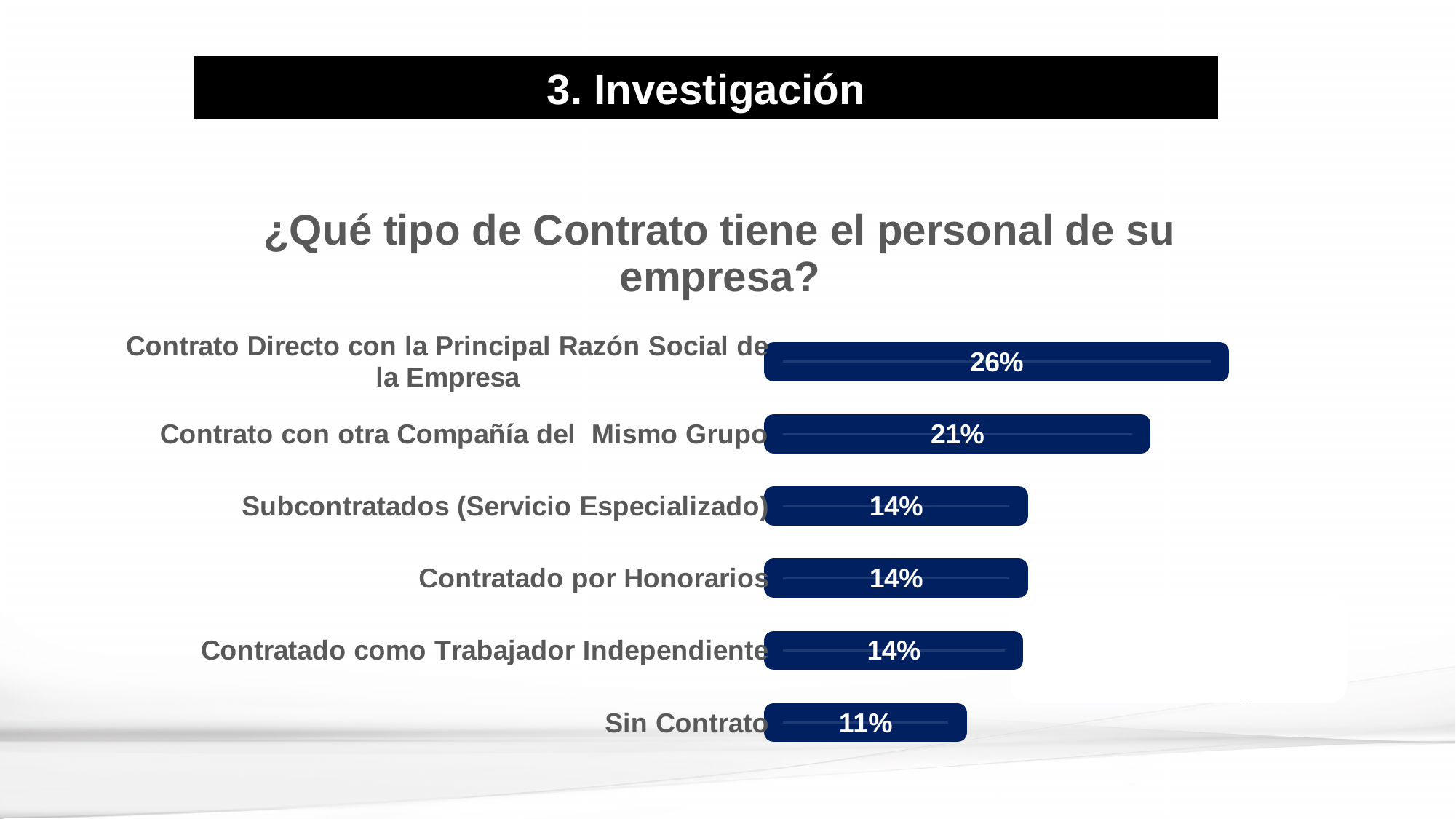
How many categories are shown in the chart? 6 Which category has the highest value? Contrato Directo con la Principal Razón Social de la Empresa What is the value for "Contrato Directo con la Principal Razón Social de la Empresa"? 26% Which is larger, the value for "Contrato con otra Compañía del Mismo Grupo" or the value for "Contratado como Trabajador Independiente"? Contrato con otra Compañía del Mismo Grupo What is the value for "Contrato con otra Compañía del Mismo Grupo"? 21% What is the value for "Sin Contrato"? 11% What kind of chart is shown on the slide? Bar chart What is the value for "Contratado por Honorarios"? 14% What is the difference between the values for "Subcontratados (Servicio Especializado)" and "Sin Contrato"? 3% Which category has the lowest value? Sin Contrato What is the difference between the values for "Contrato Directo con la Principal Razón Social de la Empresa" and "Contrato con otra Compañía del Mismo Grupo"? 5% What is the title of the chart? ¿Qué tipo de Contrato tiene el personal de su empresa?